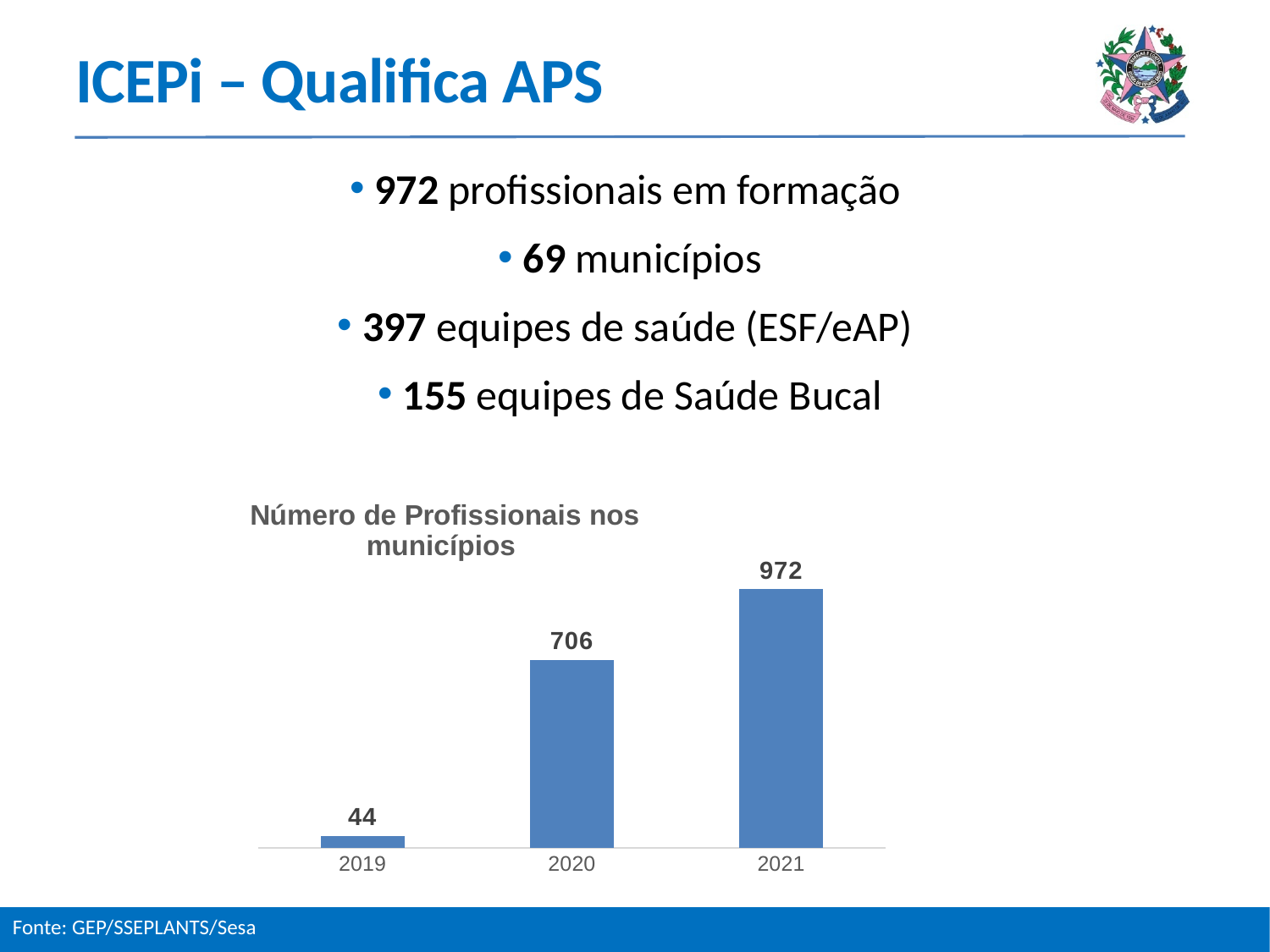
Which is larger, the value for 2020 or the value for 2019? 2020 What is the title of the chart? Número de Profissionais nos municípios What is the difference between the values for 2021 and 2020? 266 What kind of chart is shown on the slide? bar chart Which year has the highest number of professionals? 2021 What is the value for 2019 in the chart? 44 How many years are shown on the x axis of the chart? 3 What is the value for 2020 in the chart? 706 Do the values rise or fall from 2019 to 2021? rise Which year has the lowest number of professionals? 2019 What is the difference between the values for 2020 and 2019? 662 What is the value for 2021 in the chart? 972